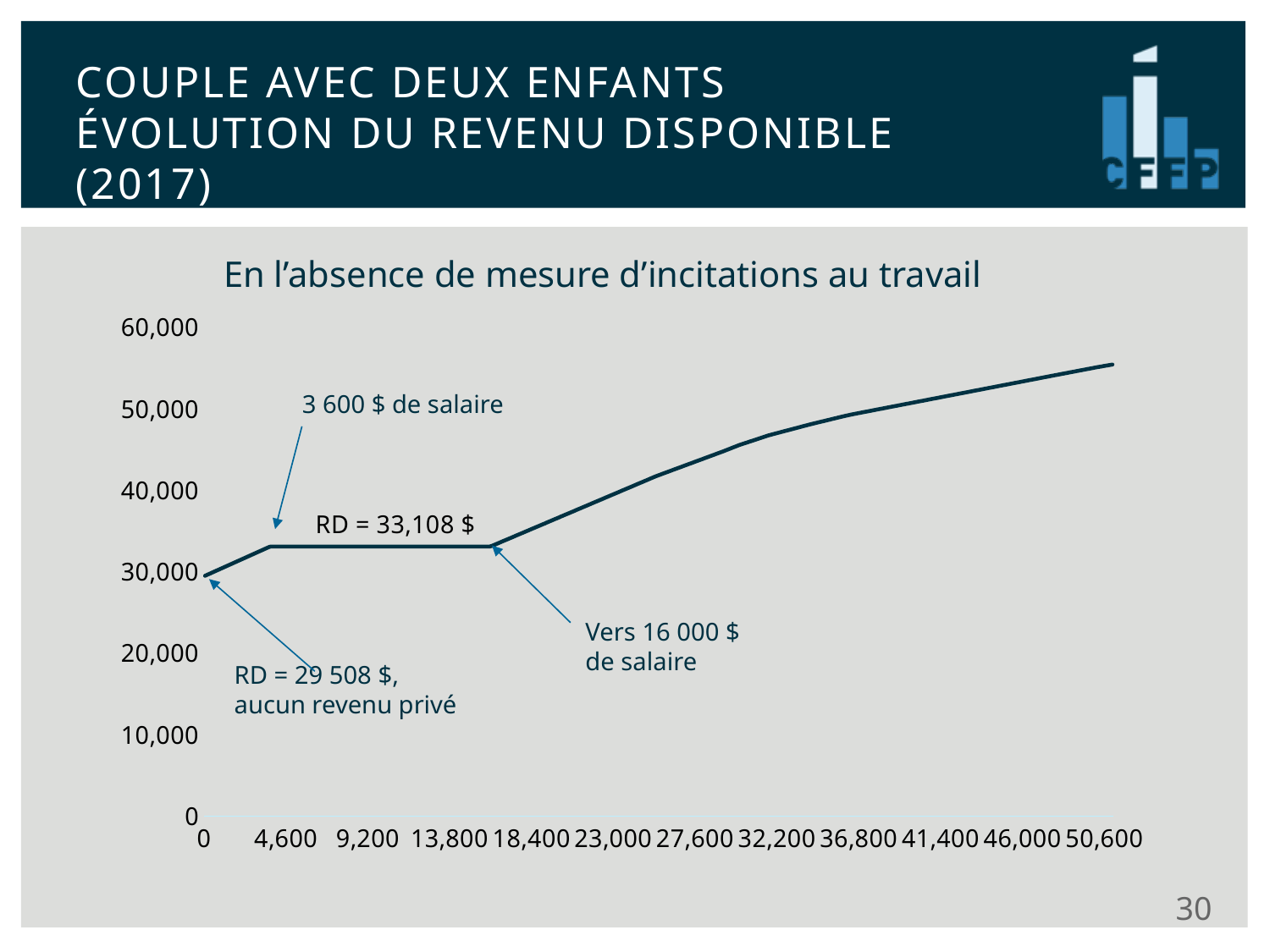
According to the annotation, what is the disposable income (RD) when there is no private income? 29 508 $ Is the value of the line at 50,600 on the x axis greater or less than 50,000? greater How many tick labels are shown on the x axis? 12 Is the value of the line at 27,600 on the x axis greater or less than 40,000? greater What kind of chart is shown on the slide? line chart What is the title of the chart? En l'absence de mesure d'incitations au travail At what salary level does the annotation say the line reaches the flat section? 3 600 $ de salaire What is the difference between the disposable income on the flat section (33,108 $) and the disposable income with no private income (29 508 $)? 3,600 $ Is the value of the line at 9,200 on the x axis greater or less than 40,000? less Around what salary level does the annotation say the line starts rising again after the flat section? Vers 16 000 $ de salaire Overall, does the line rise or fall as the x-axis value increases from 0 to 50,600? rise According to the annotation, what is the disposable income (RD) on the flat section of the line? 33,108 $